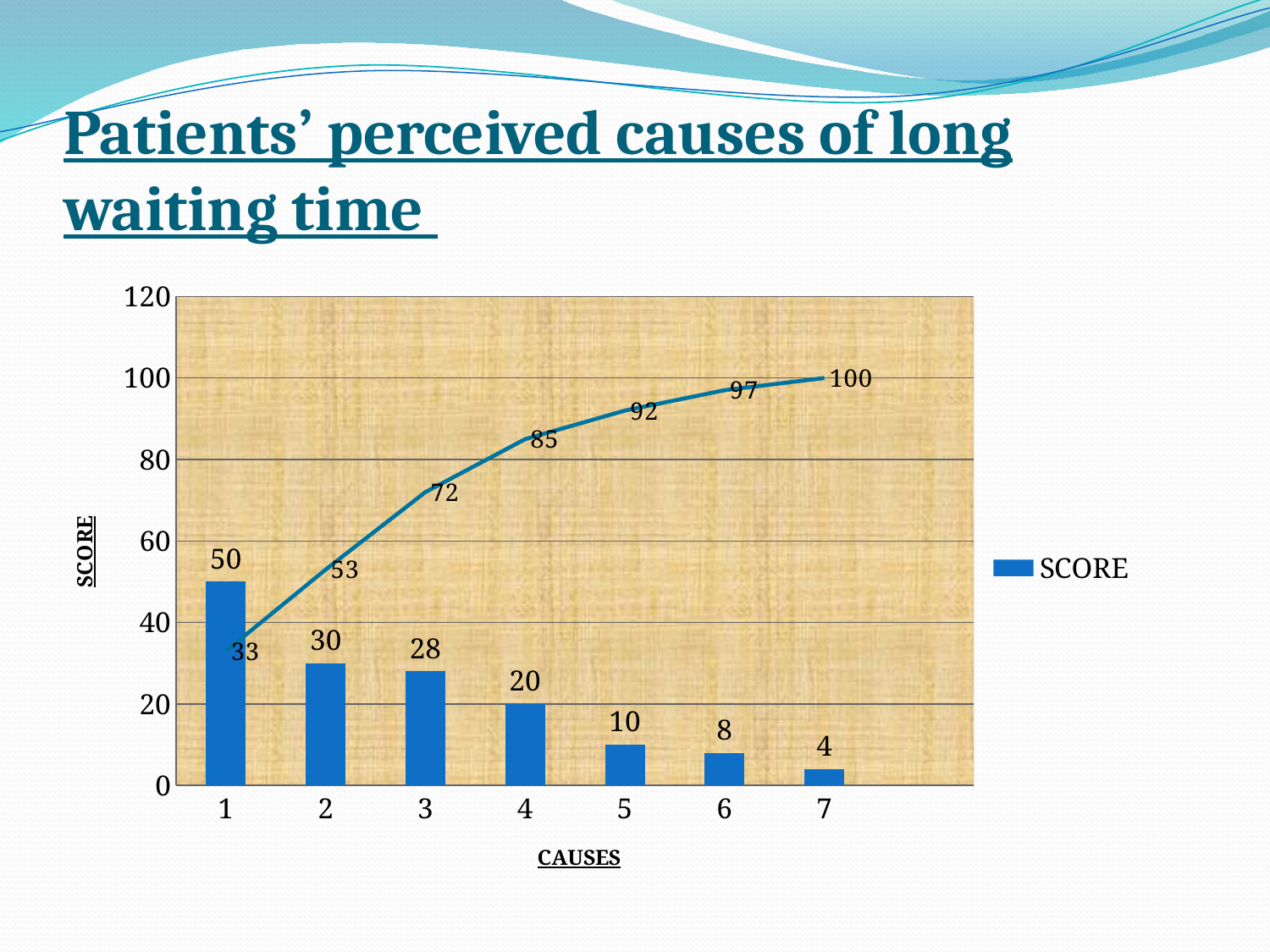
What is the score for cause 4? 20 What is the score for cause 7? 4 Which cause has the highest score bar? 1 What is the score for cause 1? 50 What is the cumulative line value at cause 3? 72 Which has a higher score, cause 3 or cause 5? Cause 3 Do the score bars rise or fall from cause 1 to cause 7? Fall What is the label on the x axis? CAUSES What is the difference between the scores for cause 1 and cause 2? 20 Which cause has the lowest score bar? 7 What is the label on the y axis? SCORE How many causes are shown on the x axis? 7